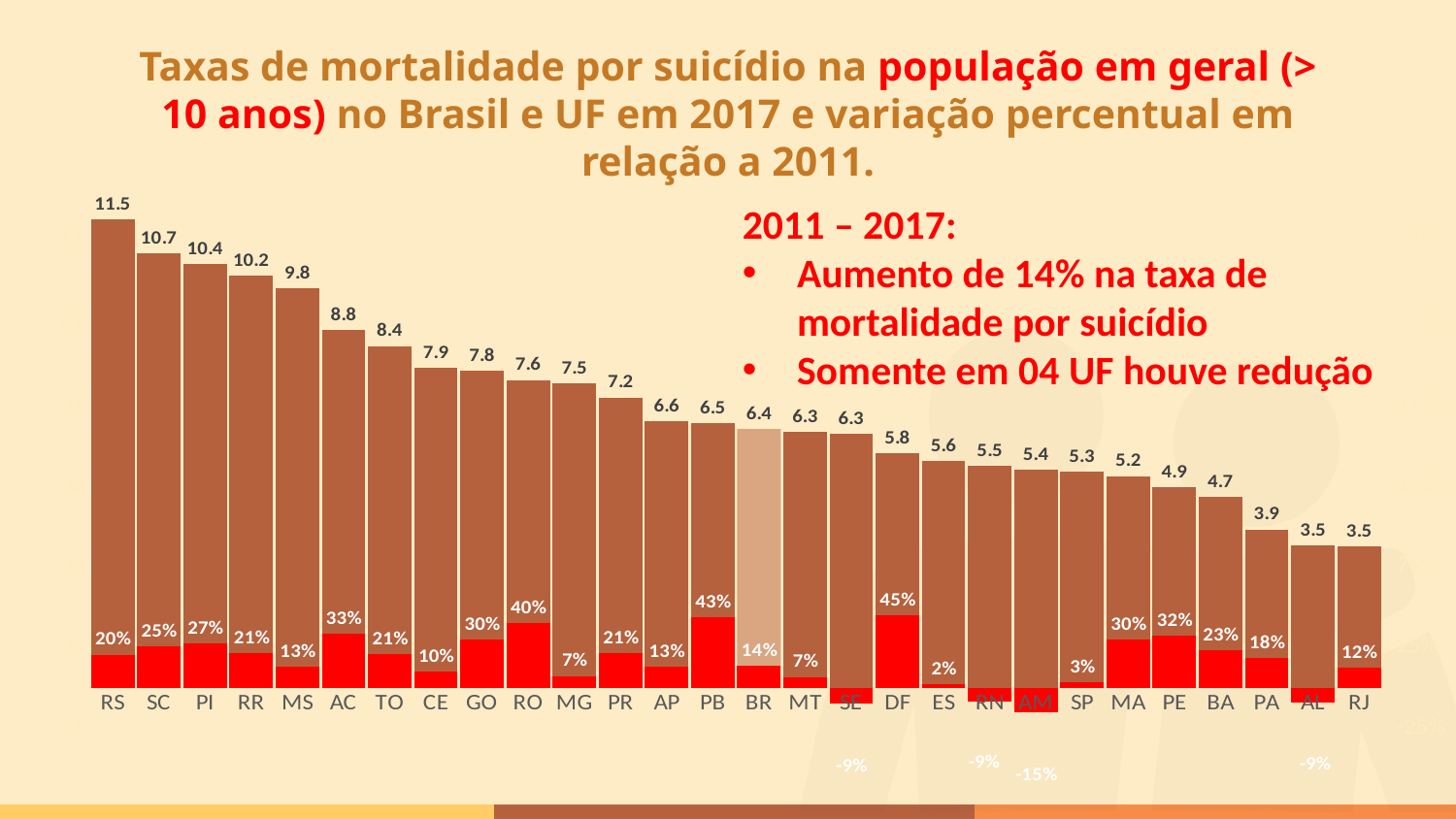
Do the 2017 mortality rate values rise or fall from left to right along the x axis? Fall Which UF has the highest suicide mortality rate in 2017? RS What percentage variation relative to 2011 is shown for DF? 45% How many categories (UFs plus BR) are shown on the x axis of the chart? 28 Which has a higher 2017 mortality rate, MS or AC? MS Which UF has the lowest percentage variation relative to 2011? AM What percentage variation relative to 2011 is shown for PB? 43% What is the suicide mortality rate shown for RS in 2017? 11.5 What is the difference between the 2017 mortality rates of RS and SC? 0.8 What kind of chart is shown on the slide? Bar chart What is the suicide mortality rate shown for BR (Brazil) in 2017? 6.4 What is the difference between the 2017 mortality rates of BR and RJ? 2.9